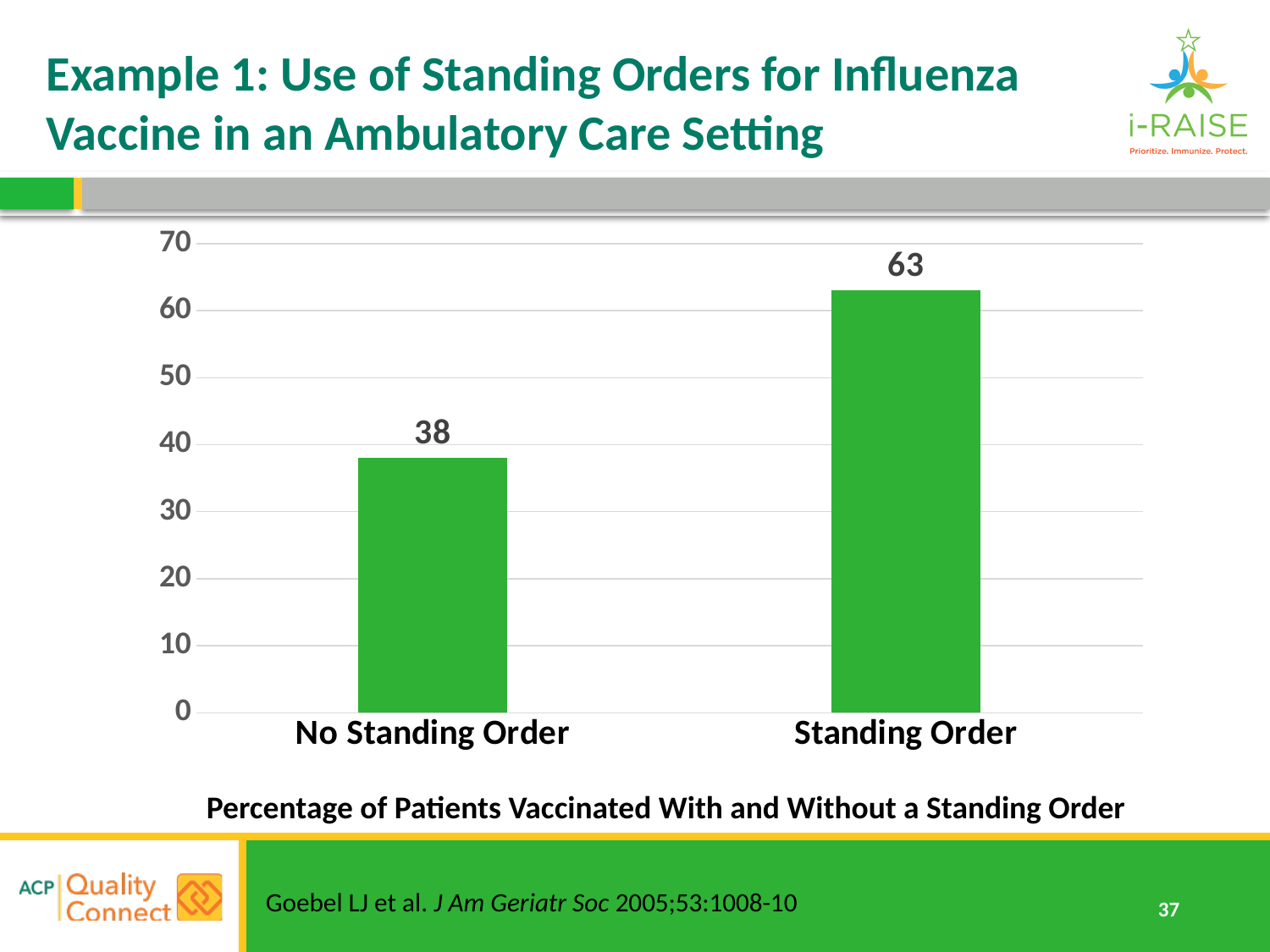
What is the value for No Standing Order? 38 Is the value for No Standing Order greater or less than 40? less What colour are the bars in the chart? green Is the value for Standing Order greater or less than 50? greater What is the difference between the values for Standing Order and No Standing Order? 25 What is the value for Standing Order? 63 Which category has the highest value? Standing Order What kind of chart is shown on the slide? bar chart What is the caption below the chart? Percentage of Patients Vaccinated With and Without a Standing Order Which category has the lowest value? No Standing Order How many categories are shown on the x axis? 2 Which is larger, the value for No Standing Order or the value for Standing Order? Standing Order